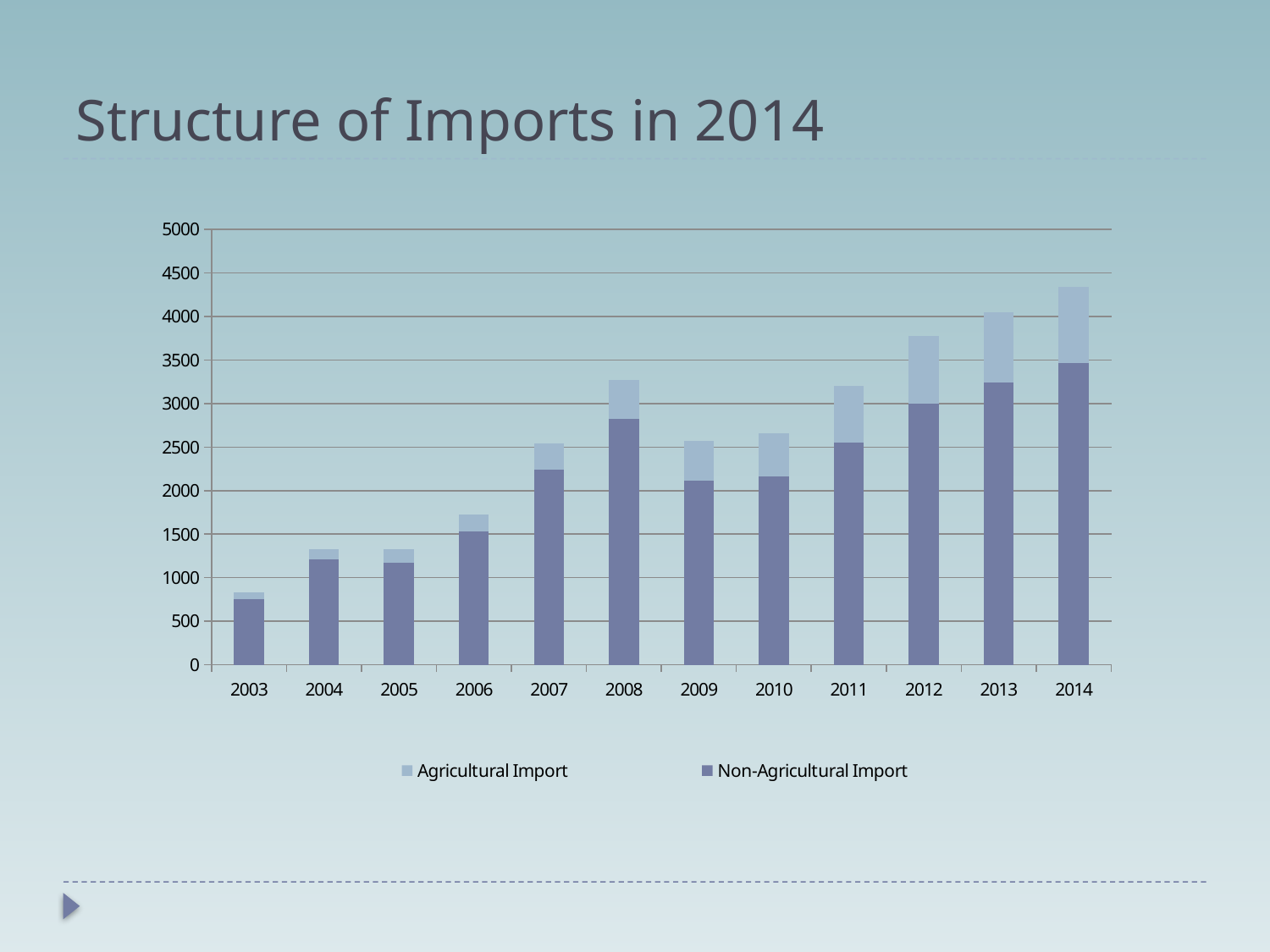
Which year has the lowest total import bar? 2003 Is the Non-Agricultural Import value for 2008 greater or less than 2500? greater Is the total import value for 2014 greater or less than 4000? greater How many series does the chart legend list? 2 Do the total import values generally rise or fall from 2003 to 2014? rise Which year has the larger total import bar, 2008 or 2009? 2008 Is the total import value for 2003 greater or less than 1000? less Which year has the highest total import bar? 2014 How many years are shown on the x axis of the chart? 12 What is the title of the slide containing the chart? Structure of Imports in 2014 What kind of chart is shown on the slide? Stacked bar chart